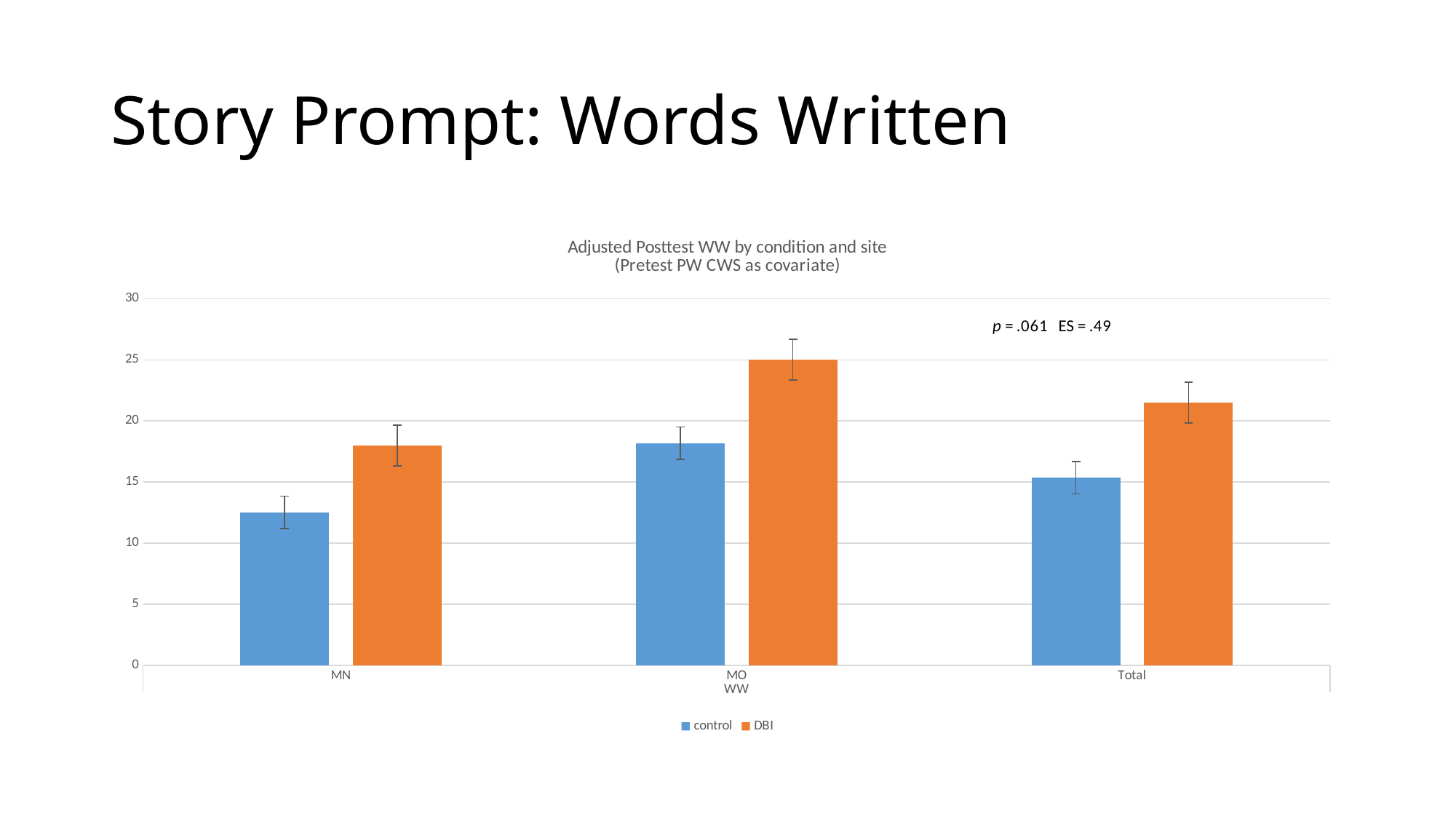
How many site categories are shown on the x axis? 3 Is the control value for Total greater or less than 20? less Which series and site has the highest bar in the chart? DBI at MO How many series does the legend list? 2 What kind of chart is shown on the slide? bar chart What are the two legend entries of the chart? control and DBI Is the control value for MN greater or less than 15? less Which series and site has the lowest bar in the chart? control at MN Is the DBI value for MN greater or less than 15? greater Which is larger, the control value for MN or the control value for Total? control for Total Which is larger, the DBI value for MO or the DBI value for Total? DBI for MO